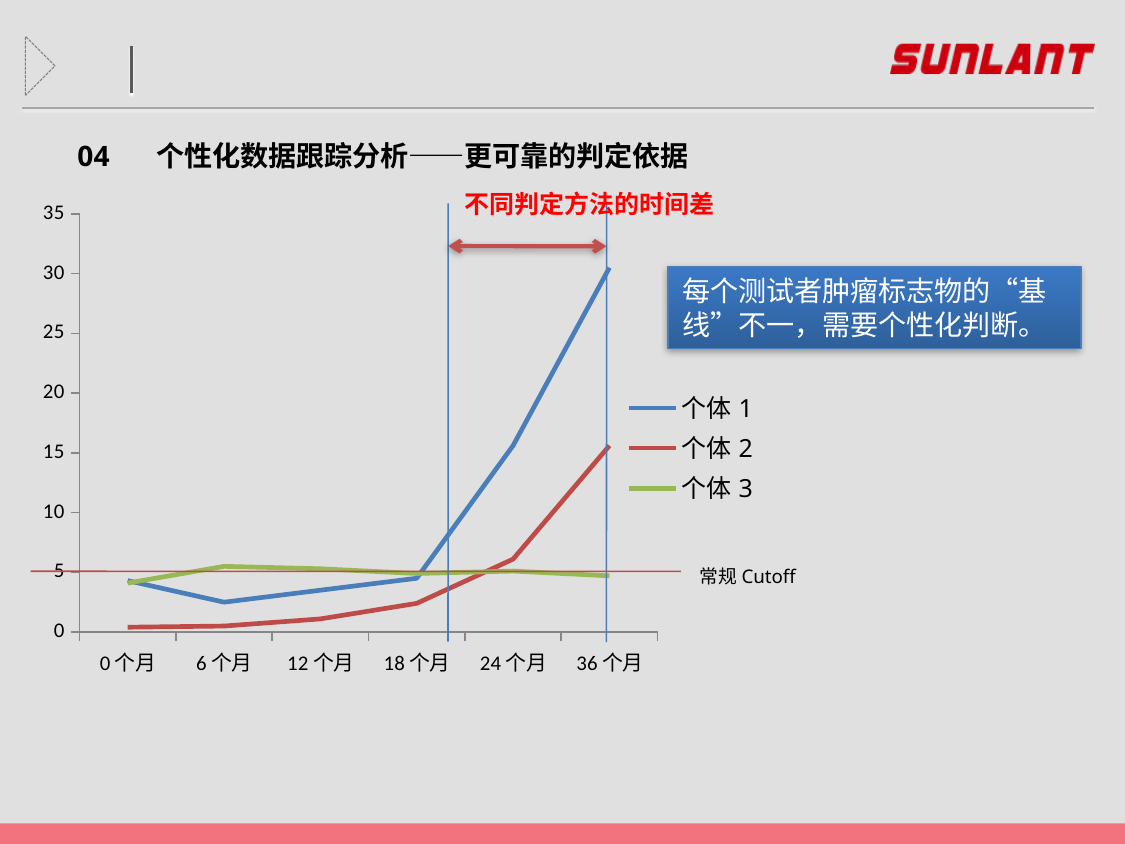
How many time points are shown on the x axis? 6 Does the value for 个体 1 rise or fall from 18 个月 to 36 个月? rise Which series has the highest value at 36 个月? 个体 1 Is the value for 个体 2 at 36 个月 greater or less than 10? greater At 6 个月, which series has the higher value, 个体 1 or 个体 3? 个体 3 Is the value for 个体 3 at 36 个月 greater or less than 10? less Is the value for 个体 1 at 36 个月 greater or less than 25? greater At 36 个月, which series has the higher value, 个体 1 or 个体 2? 个体 1 What kind of chart is shown on the slide? line chart How many series does the legend list? 3 Which series has the lowest value at 0 个月? 个体 2